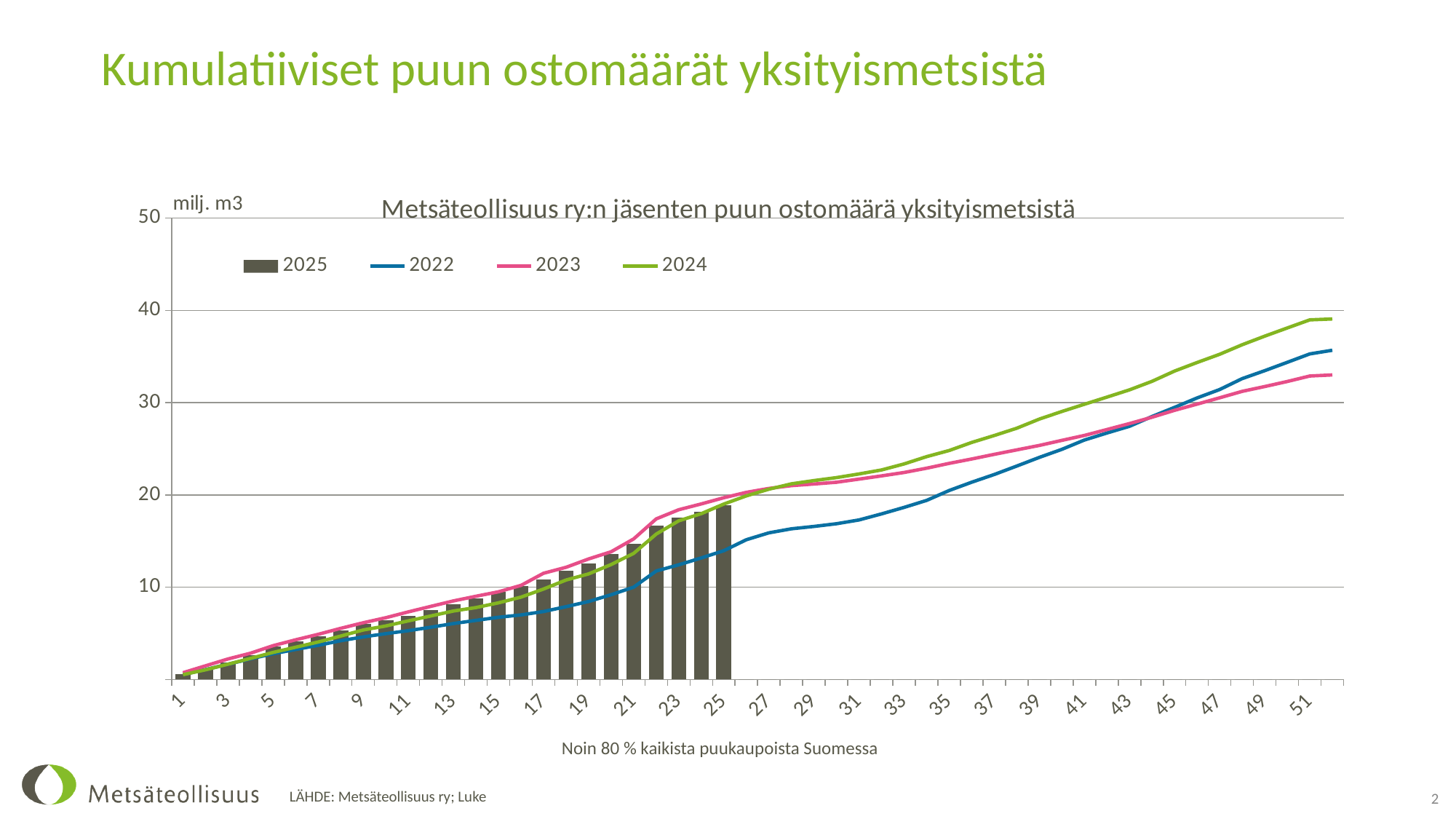
Is the value for the 2025 bar at week 25 greater or less than 20? less Which series has the lowest value at the end of the x axis (week 51)? 2023 Is the value for 2022 at week 31 greater or less than 20? less How many series does the chart legend list? 4 At week 25, which is larger: the value for 2023 or the value for 2022? 2023 Is the value for 2024 at week 51 greater or less than 30? greater Do the values for the 2024 series rise or fall along the x axis? rise Which series is shown as bars rather than a line? 2025 What kind of chart is shown on the slide? Combined bar and line chart What is the title of the chart? Metsäteollisuus ry:n jäsenten puun ostomäärä yksityismetsistä Which series has the highest value at the end of the x axis (week 51)? 2024